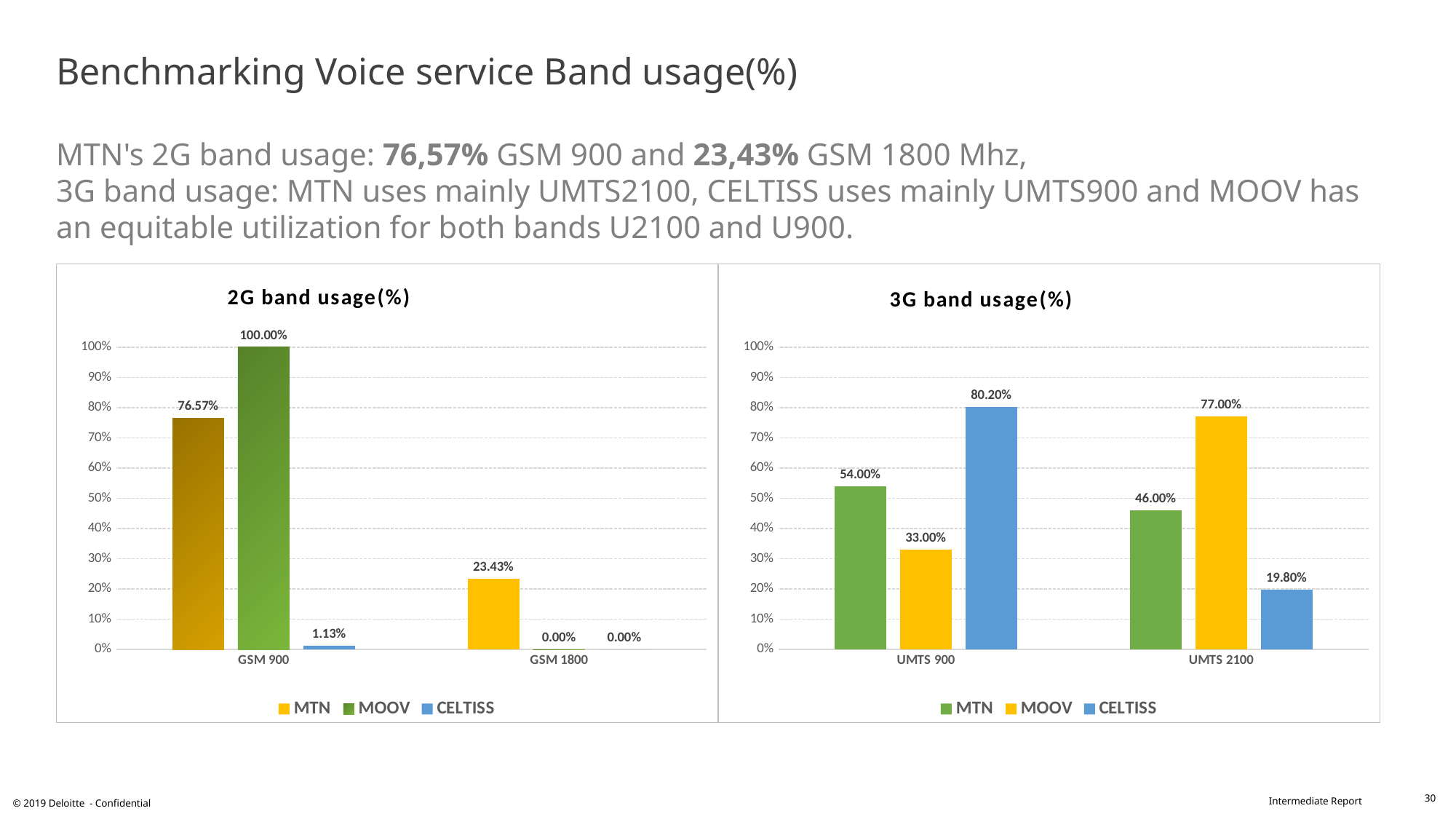
In the 3G band usage(%) chart, what is the value for CELTISS at UMTS 900? 80.20% In the 3G band usage(%) chart, what is the value for MOOV at UMTS 2100? 77.00% In the 3G band usage(%) chart, which operator has the lowest value at UMTS 2100? CELTISS In the 2G band usage(%) chart, what is the value for CELTISS at GSM 900? 1.13% In the 3G band usage(%) chart, which operator has the highest value at UMTS 900? CELTISS In the 3G band usage(%) chart, what is the difference between MTN's values at UMTS 900 and UMTS 2100? 8.00% In the 2G band usage(%) chart, what is the value for MTN at GSM 1800? 23.43% How many series does the legend of the 2G band usage(%) chart list? 3 In the 2G band usage(%) chart, what is the value for MTN at GSM 900? 76.57% What kind of chart is the 3G band usage(%) chart? Bar chart In the 2G band usage(%) chart, what is the value for MOOV at GSM 900? 100.00% In the 3G band usage(%) chart, which is larger for MOOV: UMTS 900 or UMTS 2100? UMTS 2100